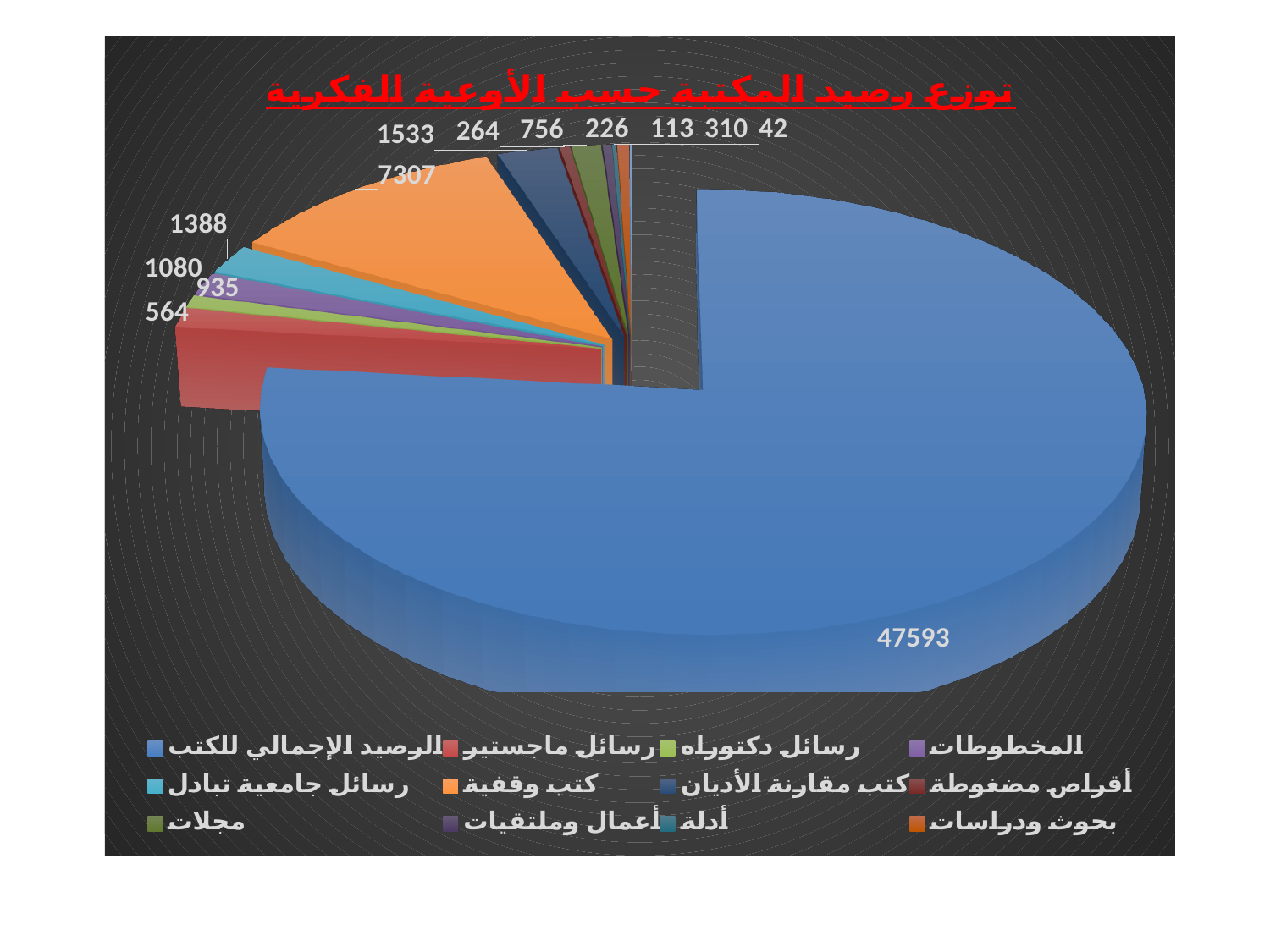
What is the difference between الرصيد الإجمالي للكتب (47593) and كتب وقفية (7307)? 40286 Which is larger, الرصيد الإجمالي للكتب or كتب وقفية? الرصيد الإجمالي للكتب What is the value of the largest slice, الرصيد الإجمالي للكتب? 47593 What is the title of the chart? توزع رصيد المكتبة حسب الأوعية الفكرية What is the value shown for كتب وقفية (the orange slice)? 7307 What is the value shown for رسائل ماجستير (the red slice)? 935 Which category has the largest slice of the pie? الرصيد الإجمالي للكتب What is the difference between كتب وقفية (7307) and رسائل جامعية تبادل (1388)? 5919 What colour is the slice for الرصيد الإجمالي للكتب? blue What kind of chart is shown on the slide? pie chart How many categories does the legend list? 12 What is the value shown for رسائل جامعية تبادل (the light blue slice)? 1388